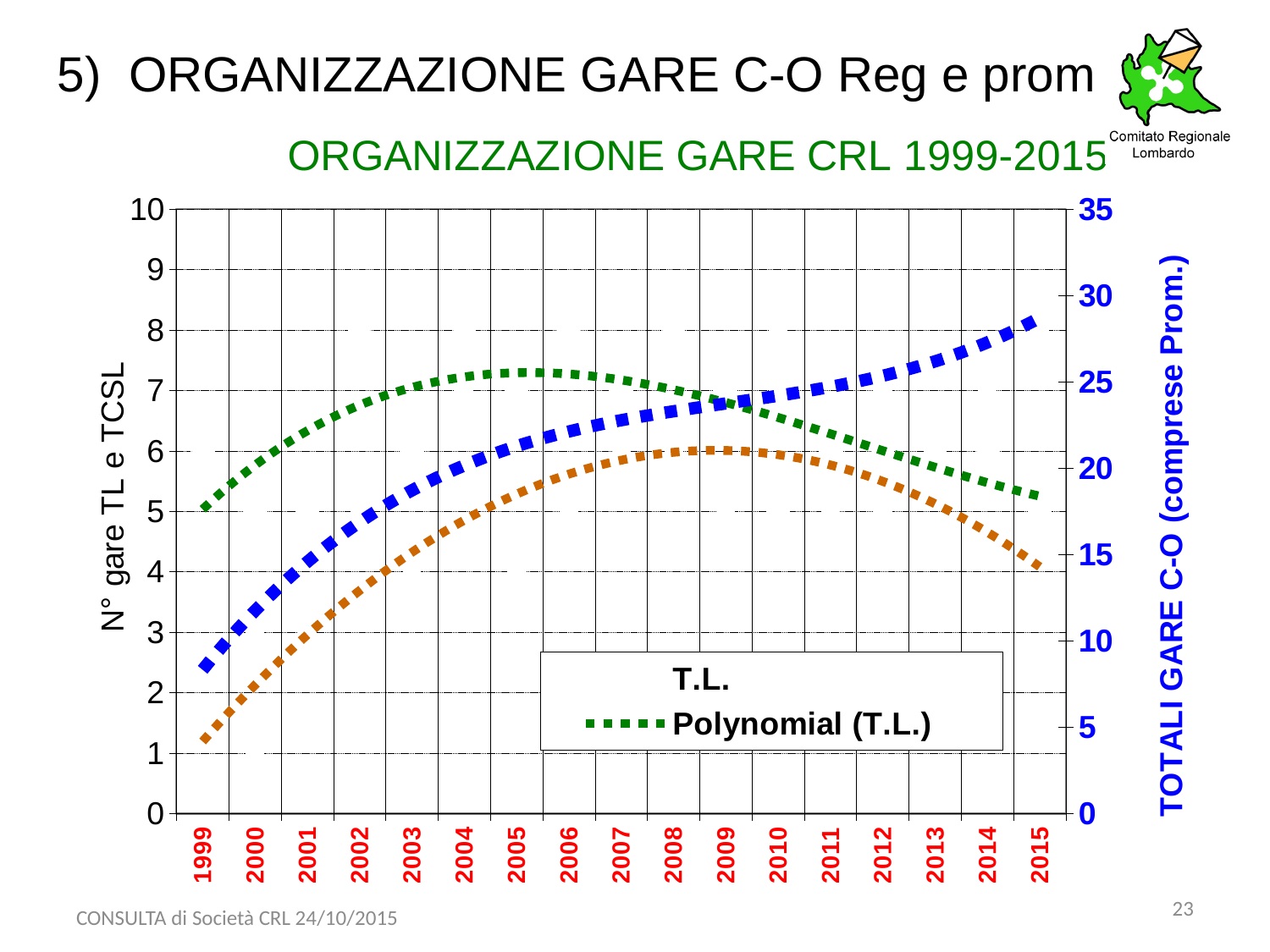
How many years are shown along the x axis of the chart? 17 Is the value of the blue dotted line in 1999, read on the right axis, greater or less than 10? less What is the title of the chart? ORGANIZZAZIONE GARE CRL 1999-2015 In which year does the blue dotted line reach its highest point? 2015 What is the label of the right-hand vertical axis? TOTALI GARE C-O (comprese Prom.) Does the blue dotted line rise or fall from 1999 to 2015? rises Is the green dotted line higher in 2005 or in 2015? 2005 Is the value of the blue dotted line in 2015, read on the right axis, greater or less than 25? greater What kind of chart is shown on the slide? line chart In 2015, which is higher: the green dotted line or the orange dotted line? the green dotted line How many entries does the chart's legend list? 2